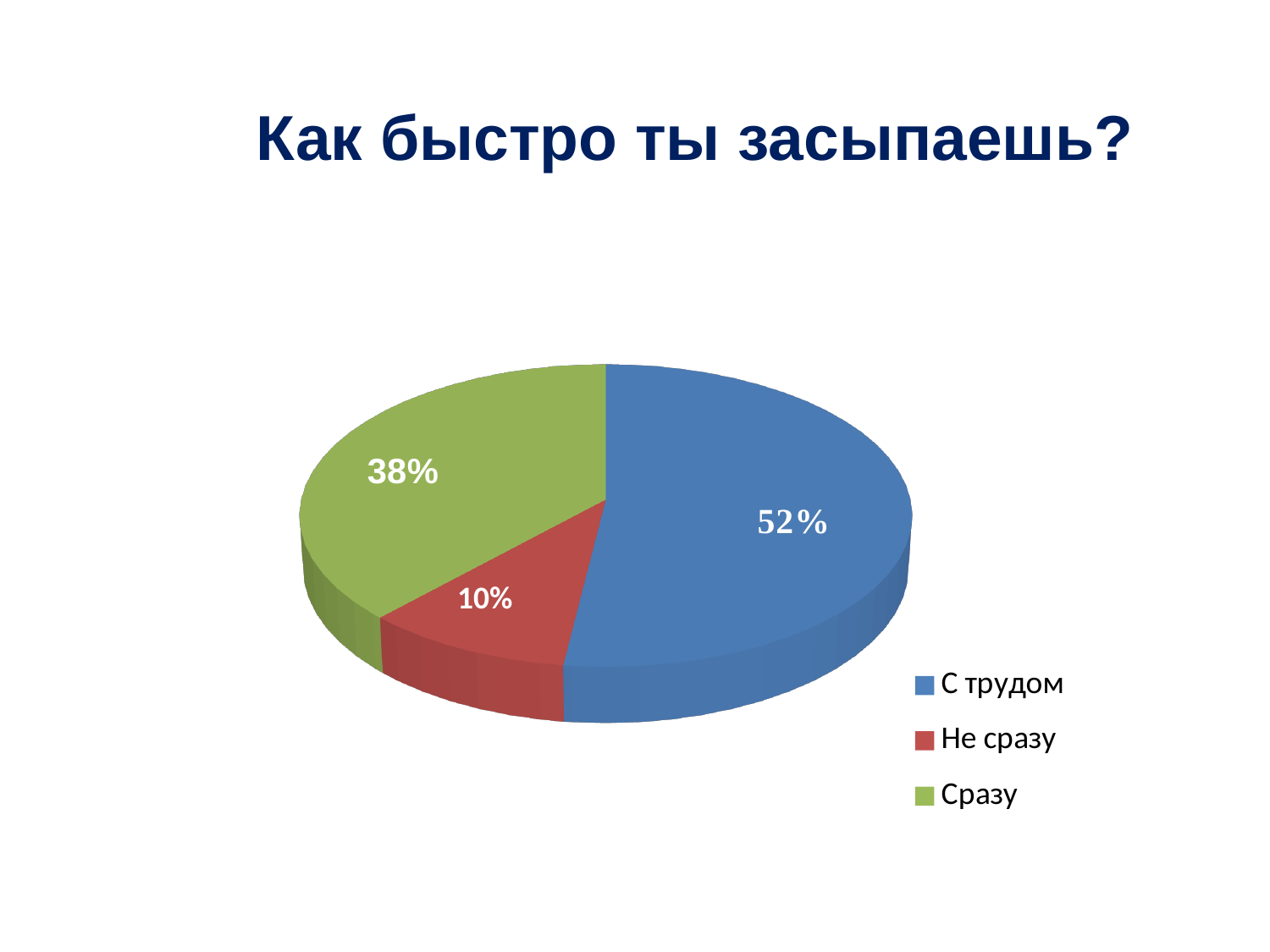
How many categories does the pie chart have? 3 Which is larger, the slice for "Сразу" or the slice for "Не сразу"? Сразу What colour is the slice for "Сразу"? green What is the difference in percentage points between "Сразу" and "Не сразу"? 28 What share of the pie does "Сразу" have? 38% Which category has the largest slice of the pie? С трудом What type of chart is shown on the slide? pie chart What share of the pie does "С трудом" have? 52% What is the title of the slide? Как быстро ты засыпаешь? What is the difference in percentage points between "С трудом" and "Сразу"? 14 Which category has the smallest slice of the pie? Не сразу What share of the pie does "Не сразу" have? 10%